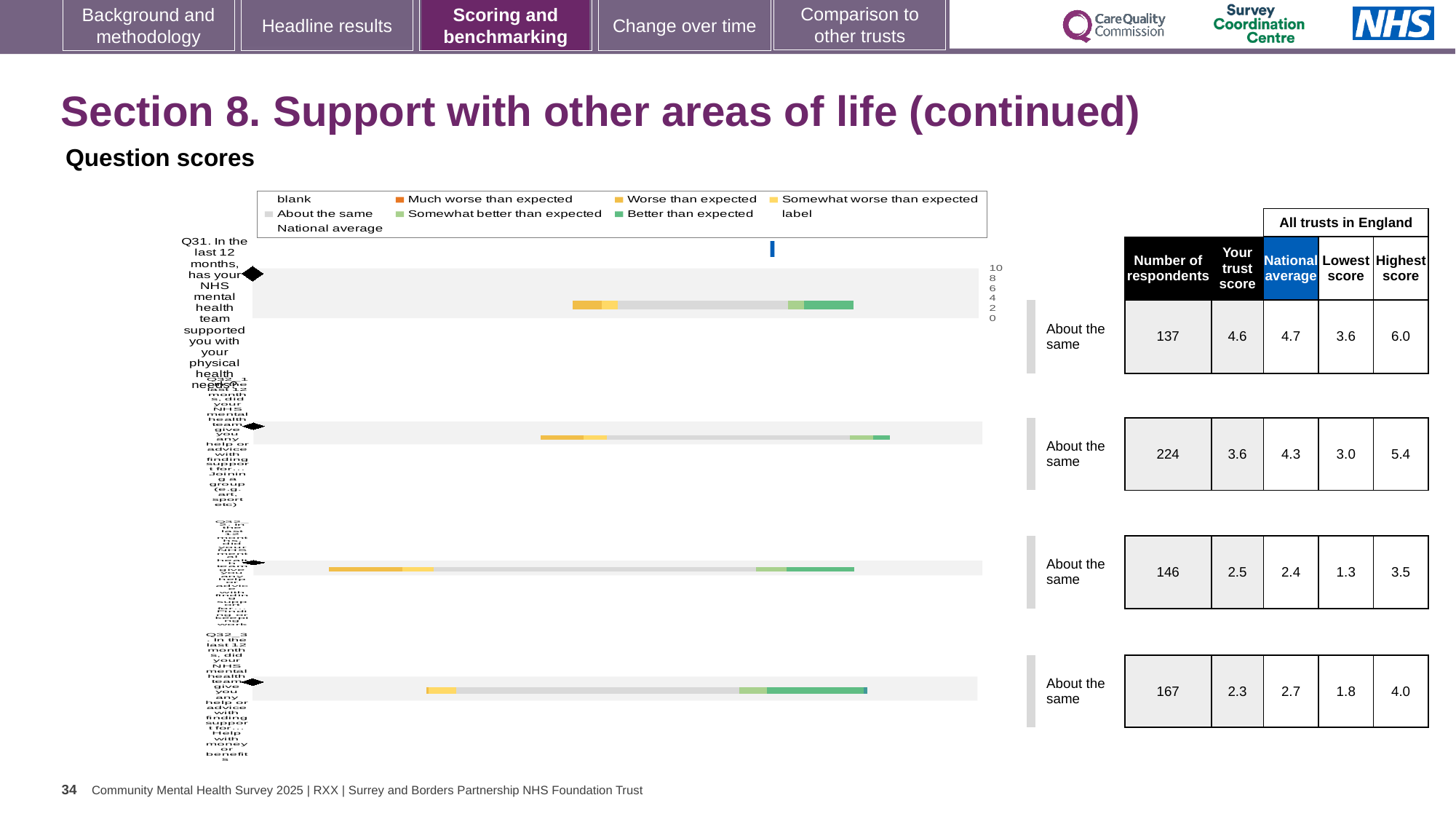
In the table beside the chart, what is the difference between the trust score and the national average for the fourth row? 0.4 What kind of chart is used to show the question scores on this slide? bar chart In the table beside the chart, what is the number of respondents for the third row? 146 In the table beside the chart, what is the national average for the first row (Q31)? 4.7 In the table beside the chart, which row has the highest number of respondents? The second row (224) How many question rows (bars) are plotted in the chart? 4 In the table beside the chart, what is the difference between the highest score and the lowest score for the first row (Q31)? 2.4 In the table beside the chart, what is the lowest trust score among the four rows? 2.3 In the table beside the chart, which is larger for the first row (Q31): the trust score or the national average? National average What is the highest value shown on the chart's numeric axis? 10 What benchmark category label is shown next to every bar in the chart? About the same In the table beside the chart, what is the trust score for the first row (Q31, physical health needs)? 4.6